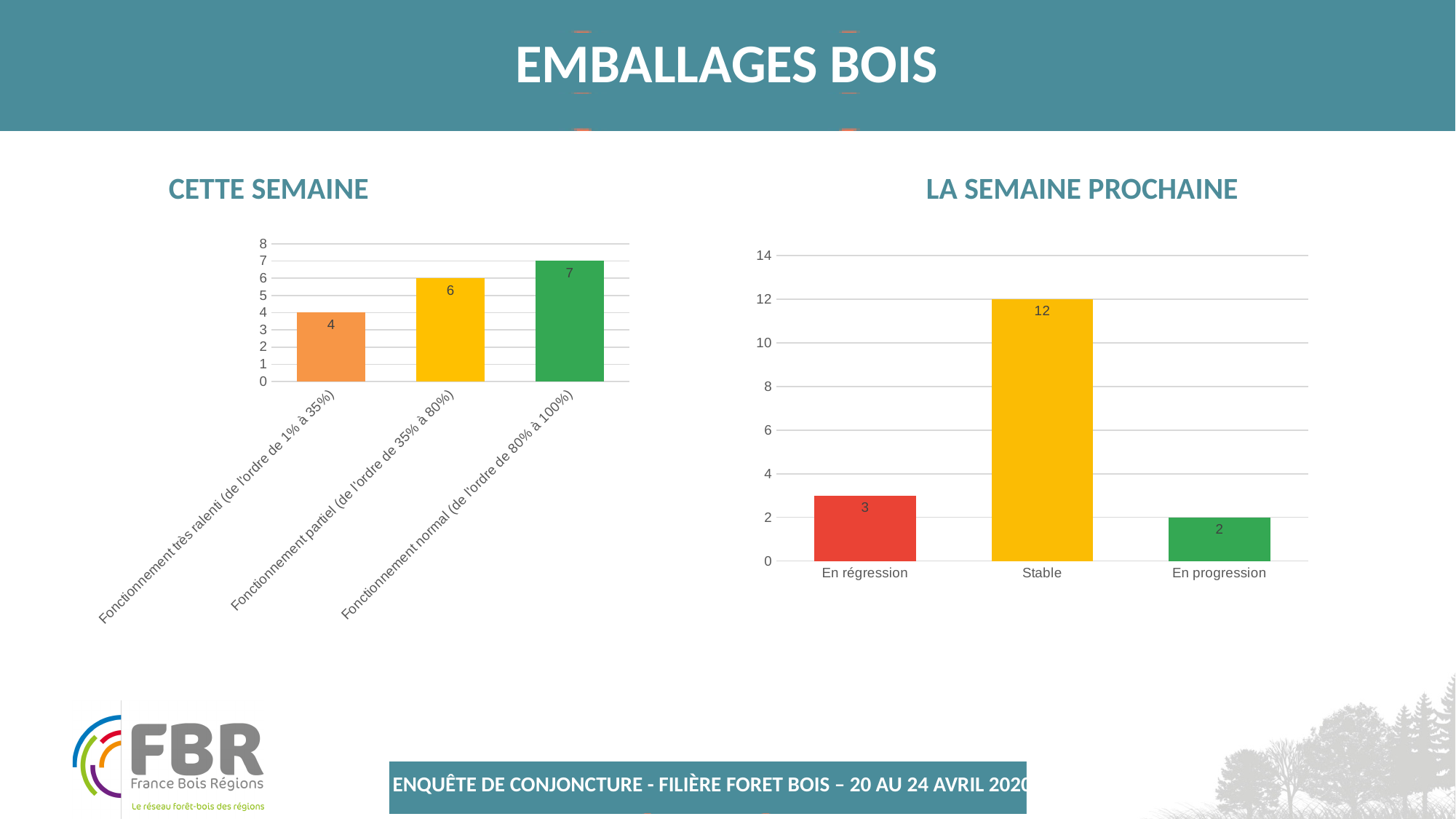
In the 'CETTE SEMAINE' chart, what is the value for 'Fonctionnement très ralenti (de l'ordre de 1% à 35%)'? 4 What kind of chart is the 'LA SEMAINE PROCHAINE' chart? bar chart In the 'LA SEMAINE PROCHAINE' chart, what is the value for 'Stable'? 12 In the 'CETTE SEMAINE' chart, how many categories are shown? 3 In the 'LA SEMAINE PROCHAINE' chart, which category has the lowest value? En progression In the 'CETTE SEMAINE' chart, which category has the highest value? Fonctionnement normal (de l'ordre de 80% à 100%) In the 'LA SEMAINE PROCHAINE' chart, what is the difference between 'Stable' and 'En régression'? 9 In the 'LA SEMAINE PROCHAINE' chart, what is the value for 'En régression'? 3 In the 'CETTE SEMAINE' chart, what is the difference between 'Fonctionnement partiel (de l'ordre de 35% à 80%)' and 'Fonctionnement très ralenti (de l'ordre de 1% à 35%)'? 2 In the 'LA SEMAINE PROCHAINE' chart, which is larger, 'En régression' or 'En progression'? En régression In the 'CETTE SEMAINE' chart, do the values rise or fall from left to right? rise In the 'CETTE SEMAINE' chart, what is the value for 'Fonctionnement normal (de l'ordre de 80% à 100%)'? 7